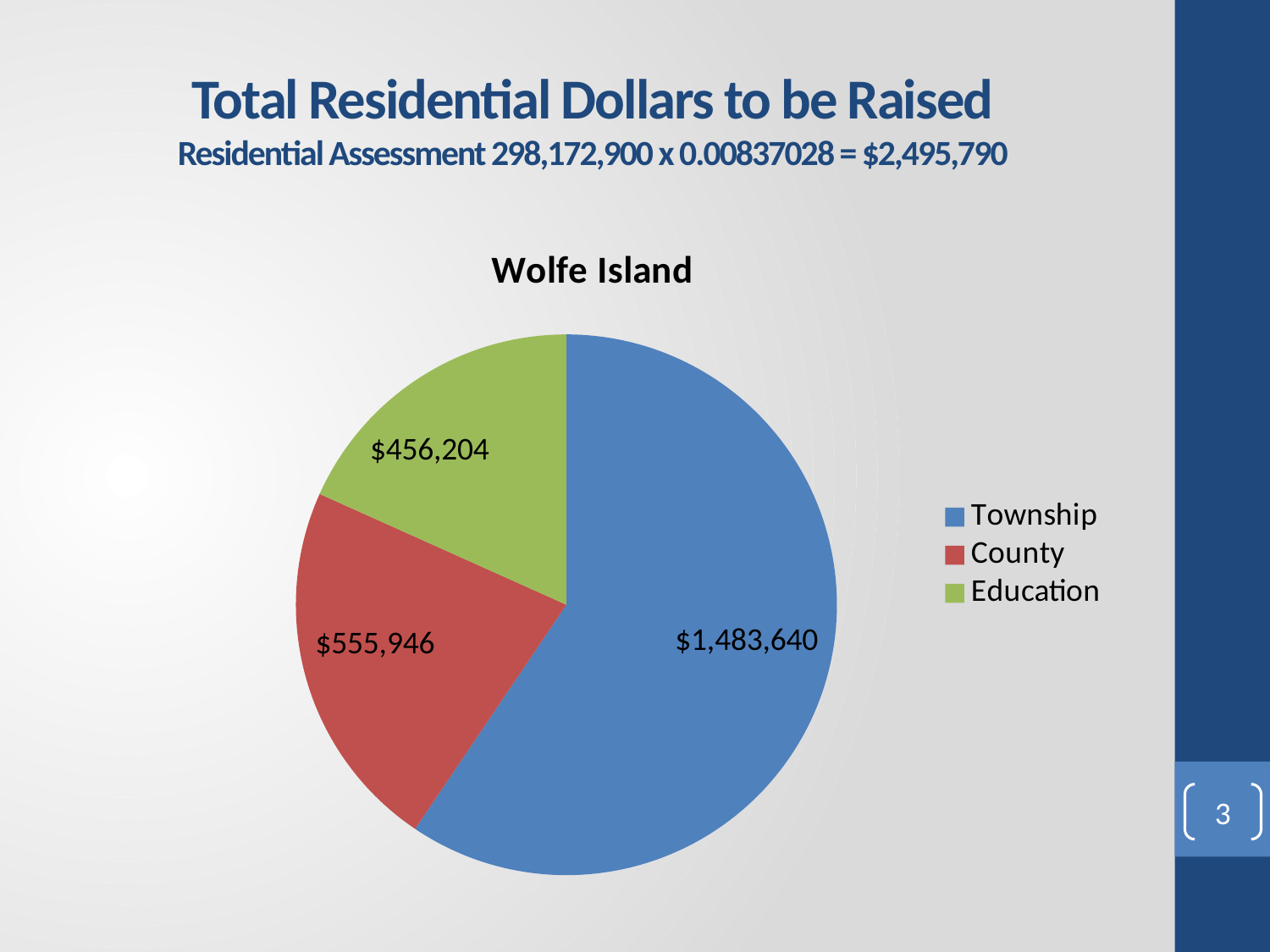
What is the difference between the Township and County values in the Wolfe Island pie chart? $927,694 Which is larger in the Wolfe Island pie chart, County or Education? County Which category has the smallest slice in the Wolfe Island pie chart? Education What is the total of all slices in the Wolfe Island pie chart? $2,495,790 What is the value for County in the Wolfe Island pie chart? $555,946 To the nearest whole percent, what share of the Wolfe Island pie does Township represent? 59% What is the value for Education in the Wolfe Island pie chart? $456,204 What kind of chart is shown on the slide? Pie chart What is the difference between the County and Education values in the Wolfe Island pie chart? $99,742 What is the value for Township in the Wolfe Island pie chart? $1,483,640 How many categories are shown in the Wolfe Island pie chart? 3 Which category has the largest slice in the Wolfe Island pie chart? Township